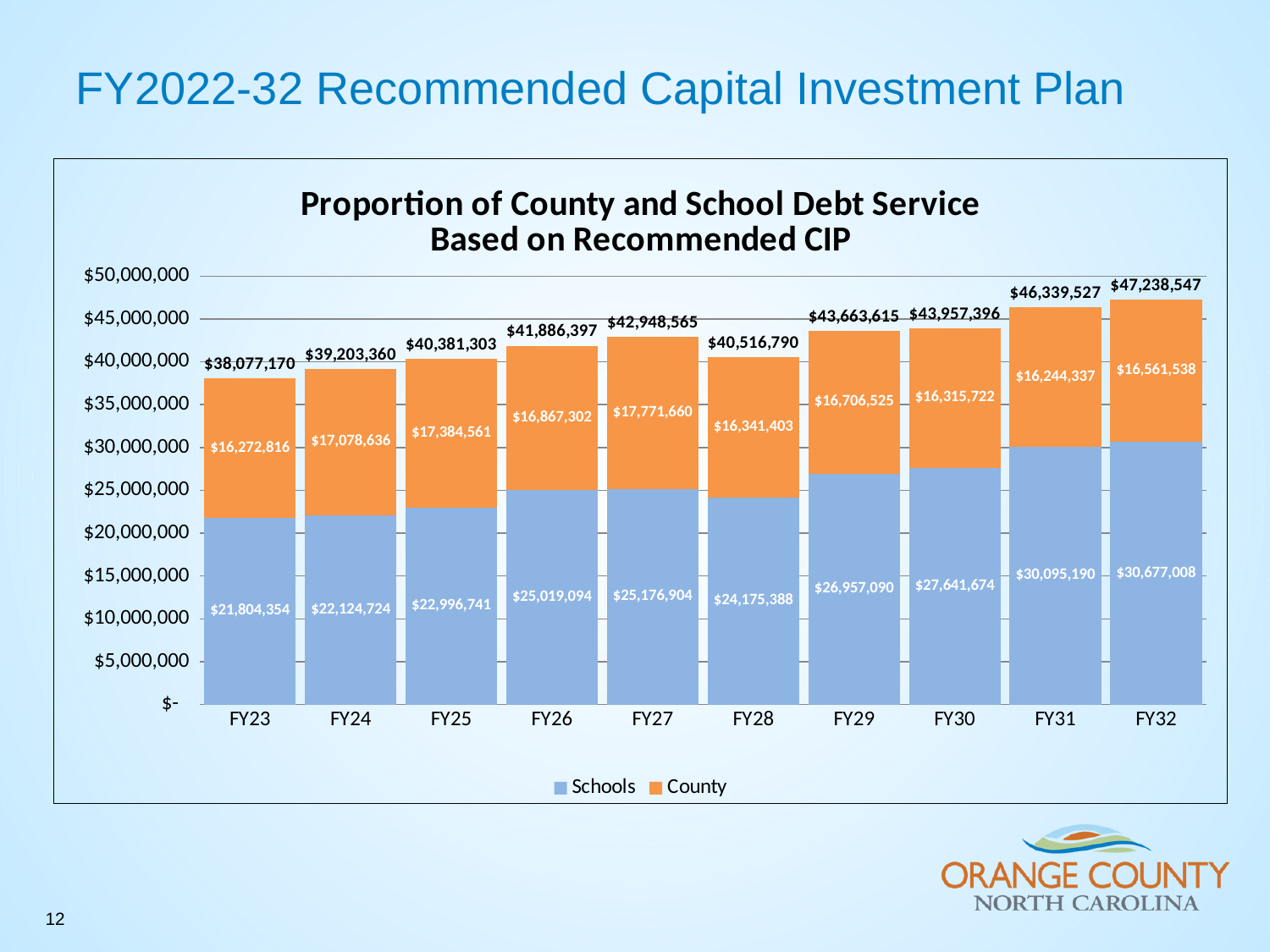
What is the County debt service value for FY30? $16,315,722 Which is larger, the County value for FY25 or the County value for FY26? FY25 What is the difference between the Schools value in FY32 and the Schools value in FY23? $8,872,654 What is the Schools debt service value for FY26? $25,019,094 Which series is shown in orange in the chart? County Is the total debt service for FY23 greater or less than $40,000,000? less What kind of chart is shown on the slide? Stacked bar chart What is the total debt service shown for FY27? $42,948,565 Which fiscal year has the lowest Schools debt service value? FY23 How many fiscal years are shown on the x axis? 10 Which fiscal year has the highest County debt service value? FY27 How many series does the legend list? 2